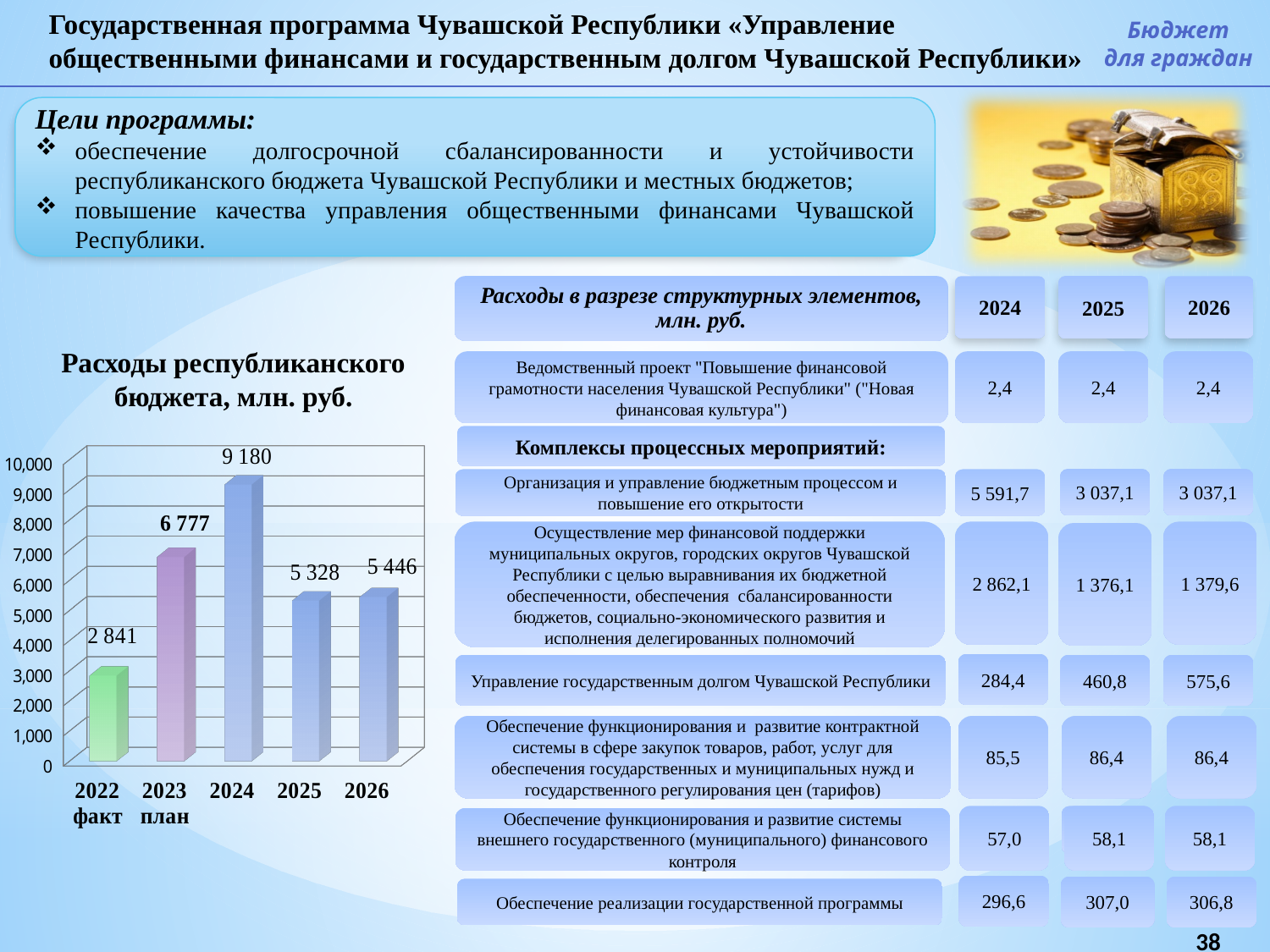
What is the value for 2026 in the chart 'Расходы республиканского бюджета, млн. руб.'? 5 446 What is the value for 2022 in the chart 'Расходы республиканского бюджета, млн. руб.'? 2 841 What is the value for 2024 in the chart 'Расходы республиканского бюджета, млн. руб.'? 9 180 Which year has the lowest value in the chart 'Расходы республиканского бюджета, млн. руб.'? 2022 What is the difference between the 2024 and 2023 values in the chart 'Расходы республиканского бюджета, млн. руб.'? 2 403 Which year has the highest value in the chart 'Расходы республиканского бюджета, млн. руб.'? 2024 What kind of chart is 'Расходы республиканского бюджета, млн. руб.'? bar chart In the chart 'Расходы республиканского бюджета, млн. руб.', does the value rise or fall from 2024 to 2025? fall How many years are shown in the chart 'Расходы республиканского бюджета, млн. руб.'? 5 In the chart 'Расходы республиканского бюджета, млн. руб.', is the value for 2023 greater or less than 6,000? greater What is the difference between the 2026 and 2025 values in the chart 'Расходы республиканского бюджета, млн. руб.'? 118 In the chart 'Расходы республиканского бюджета, млн. руб.', which is larger: the value for 2025 or for 2026? 2026